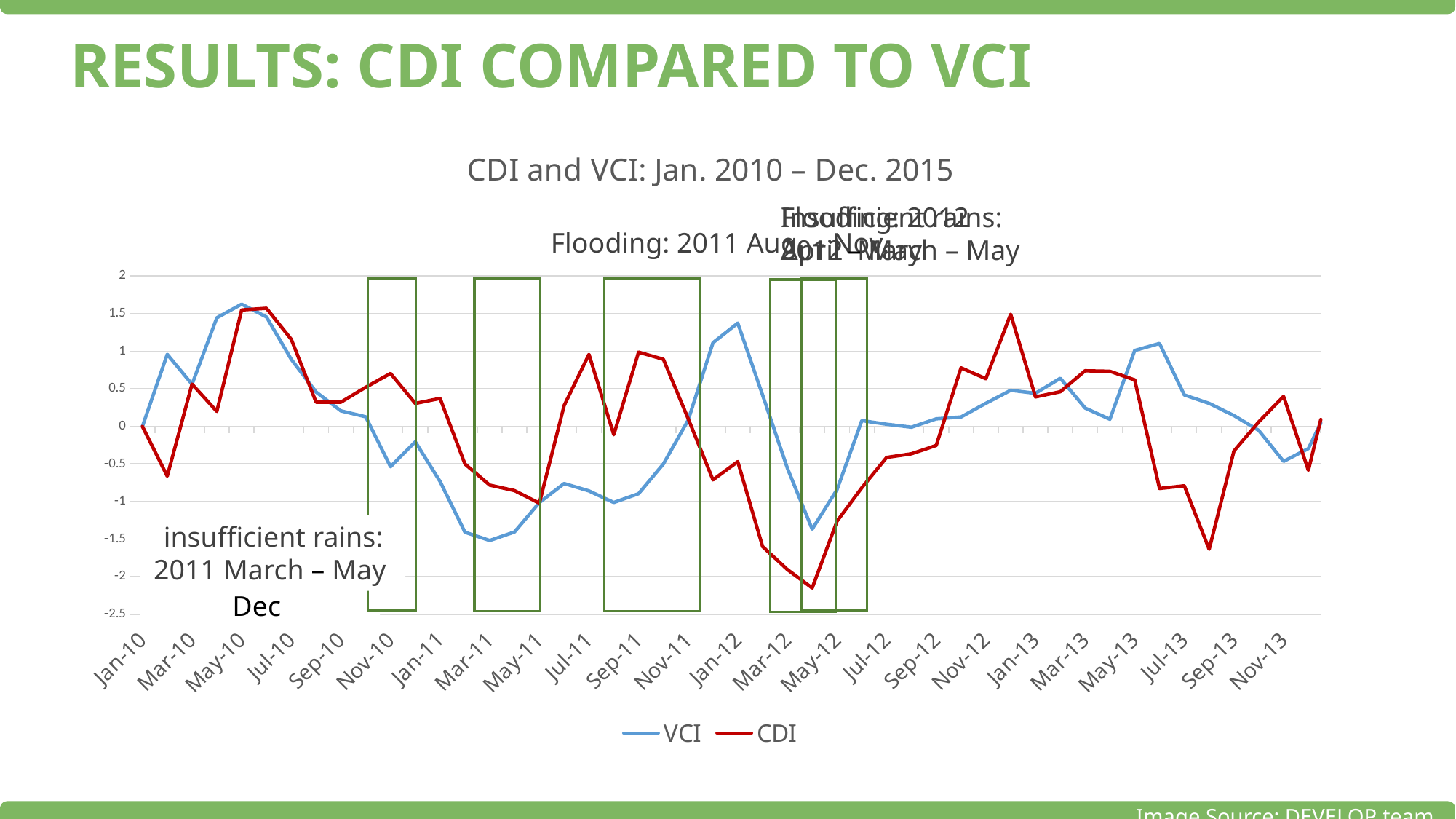
Which colour is used for the CDI line? red Is the CDI value at Apr-12 greater or less than -1.5? less How many series does the chart legend list? 2 What is the title of the chart? CDI and VCI: Jan. 2010 – Dec. 2015 At Jan-12, which series has the higher value, VCI or CDI? VCI Which series reaches the lowest value anywhere on the chart? CDI At Sep-11, which series has the higher value, VCI or CDI? CDI Is the VCI value at Mar-11 greater or less than -1? less Is the CDI value at Dec-12 greater or less than 1? greater Does the VCI line rise or fall from Jun-10 to Sep-10? fall What kind of chart is shown on the slide? line chart